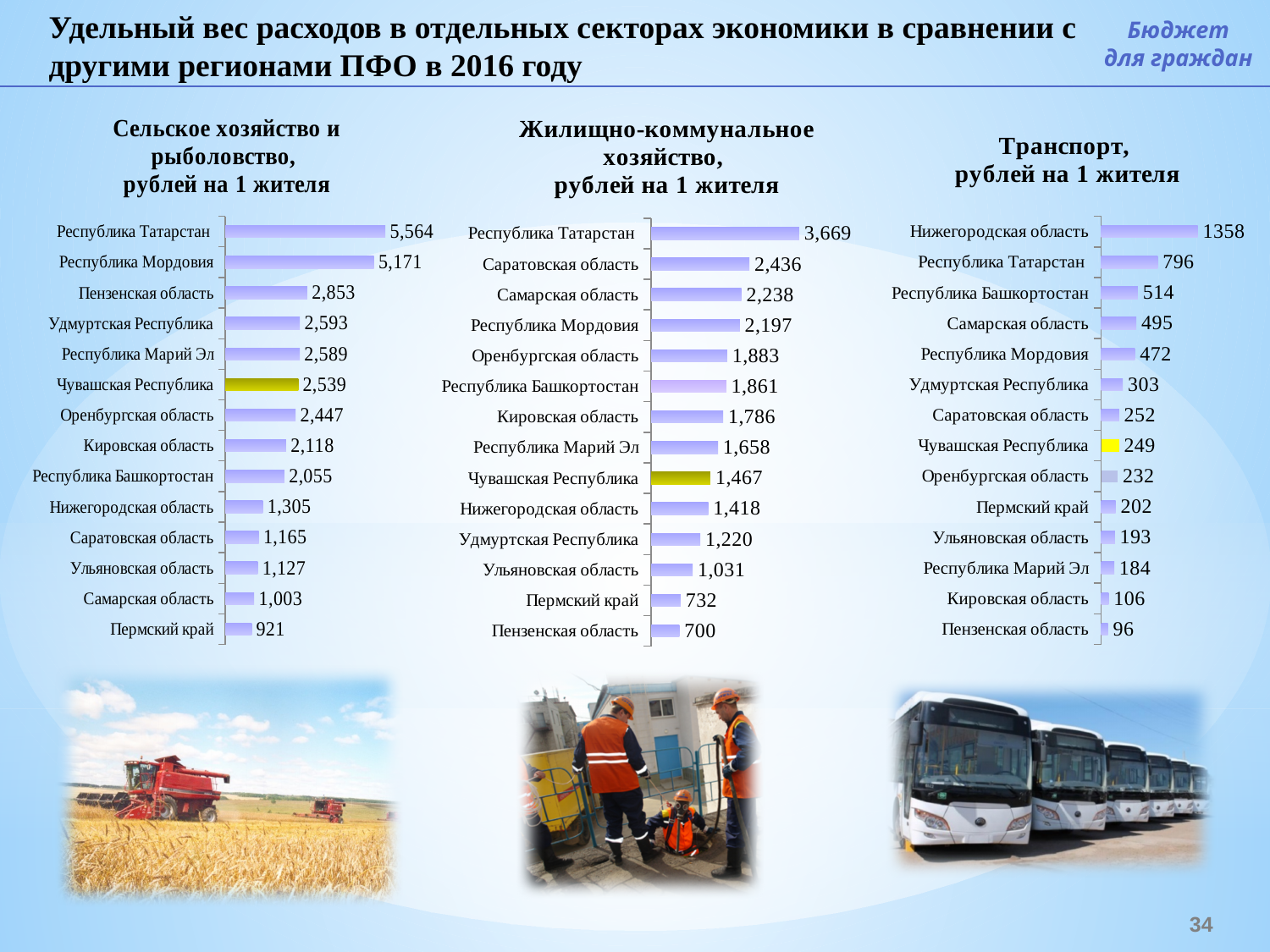
In the chart 'Жилищно-коммунальное хозяйство, рублей на 1 жителя', which region has the lowest value? Пензенская область In the chart 'Жилищно-коммунальное хозяйство, рублей на 1 жителя', which is larger: Кировская область or Республика Марий Эл? Кировская область In the chart 'Жилищно-коммунальное хозяйство, рублей на 1 жителя', what is the value for Саратовская область? 2,436 In the chart 'Сельское хозяйство и рыболовство, рублей на 1 жителя', what is the difference between Республика Татарстан and Республика Мордовия? 393 In the chart 'Транспорт, рублей на 1 жителя', which region's bar is highlighted in yellow? Чувашская Республика In the chart 'Сельское хозяйство и рыболовство, рублей на 1 жителя', which region has the highest value? Республика Татарстан In the chart 'Сельское хозяйство и рыболовство, рублей на 1 жителя', which region has the lowest value? Пермский край In the chart 'Транспорт, рублей на 1 жителя', what is the difference between Республика Татарстан and Чувашская Республика? 547 In the chart 'Жилищно-коммунальное хозяйство, рублей на 1 жителя', how many regions are shown? 14 What type of chart is 'Транспорт, рублей на 1 жителя'? Bar chart In the chart 'Сельское хозяйство и рыболовство, рублей на 1 жителя', what is the value for Чувашская Республика? 2,539 In the chart 'Транспорт, рублей на 1 жителя', what is the value for Нижегородская область? 1358